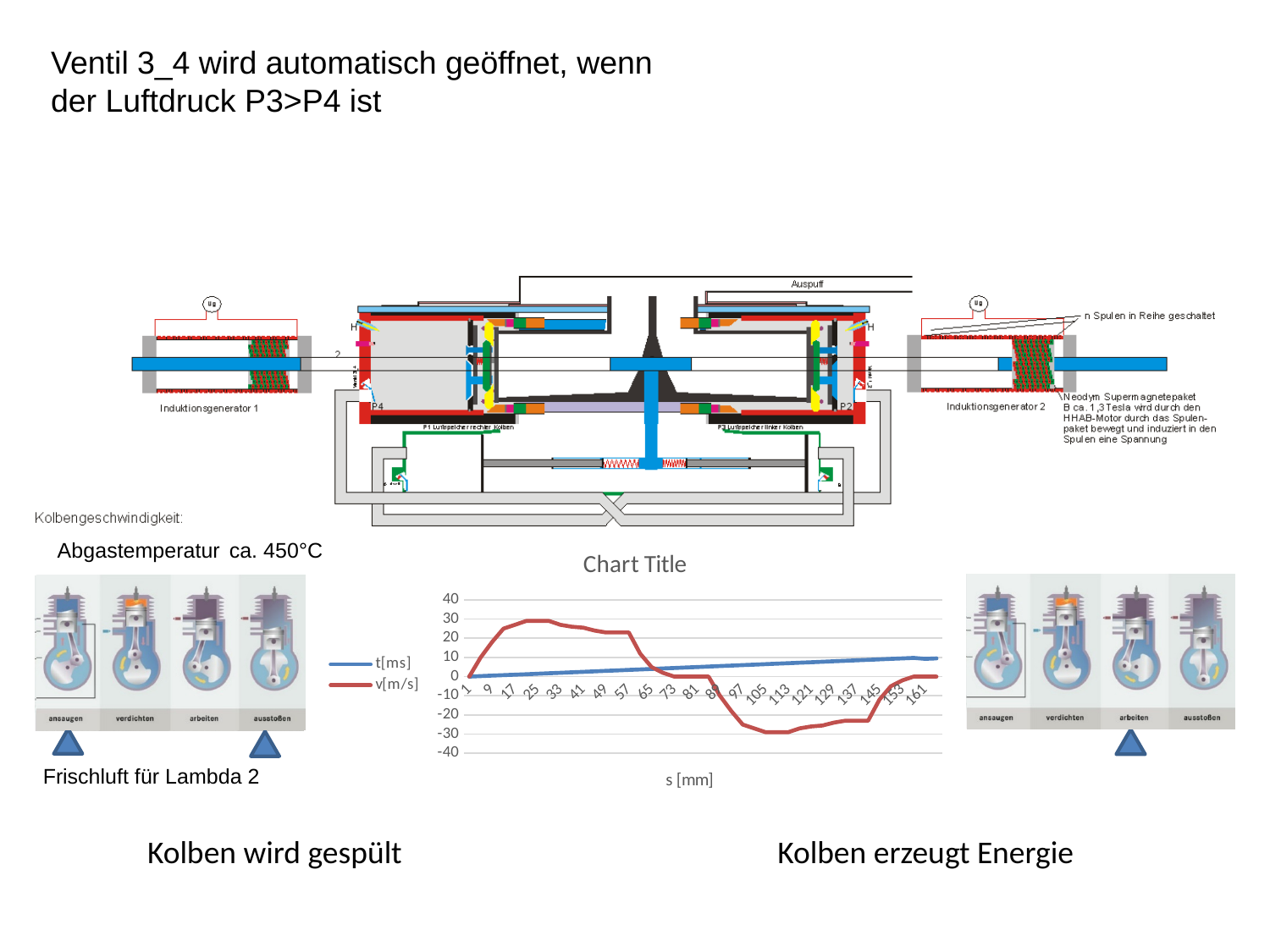
What are the two series named in the chart legend? t[ms] and v[m/s] Does the v[m/s] series rise or fall between s = 57 and s = 113? fall Is the value of v[m/s] at s = 25 greater or less than 20? greater Is the value of v[m/s] at s = 113 greater or less than -20? less How many series does the legend of the chart list? 2 Which is larger, v[m/s] at s = 25 or v[m/s] at s = 113? v[m/s] at s = 25 Is the value of v[m/s] at s = 57 greater or less than 10? greater What is the label of the x axis of the chart? s [mm] Which series has the larger value at s = 57, t[ms] or v[m/s]? v[m/s] What kind of chart is shown under "Chart Title"? line chart Does the t[ms] series rise or fall along the x axis? rise